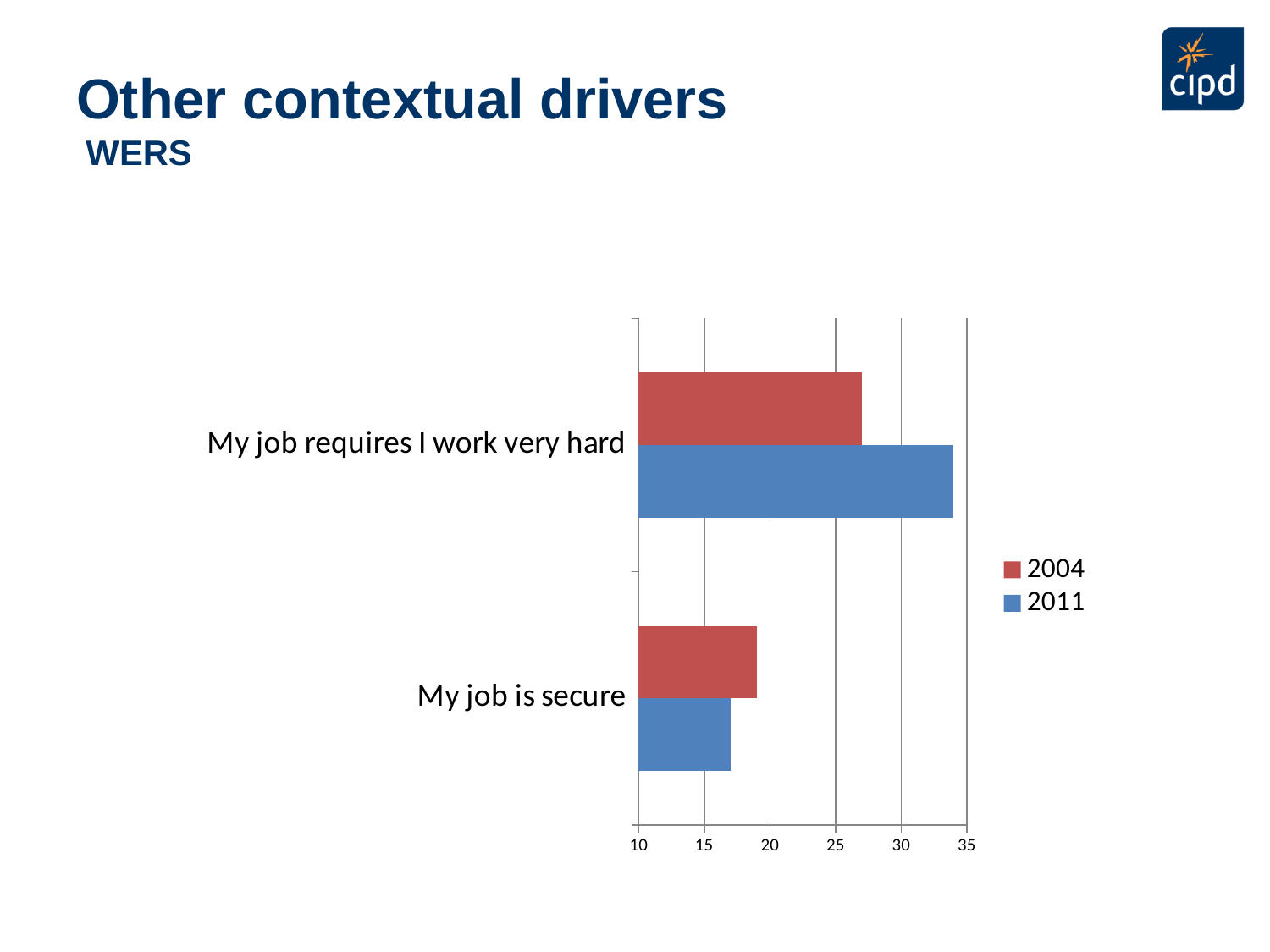
How many series does the legend list? 2 What colour represents the 2011 series? blue What kind of chart is shown on the slide? bar chart Is the 2011 value for 'My job is secure' greater or less than 15? greater For 'My job requires I work very hard', which year has the larger value, 2004 or 2011? 2011 Is the 2004 value for 'My job requires I work very hard' greater or less than 25? greater For 'My job is secure', which year has the larger value, 2004 or 2011? 2004 Is the 2011 value for 'My job is secure' greater or less than 20? less How many categories are plotted on the chart? 2 Which years are listed in the chart's legend? 2004 and 2011 Which bar on the chart is the longest? 2011 for 'My job requires I work very hard'